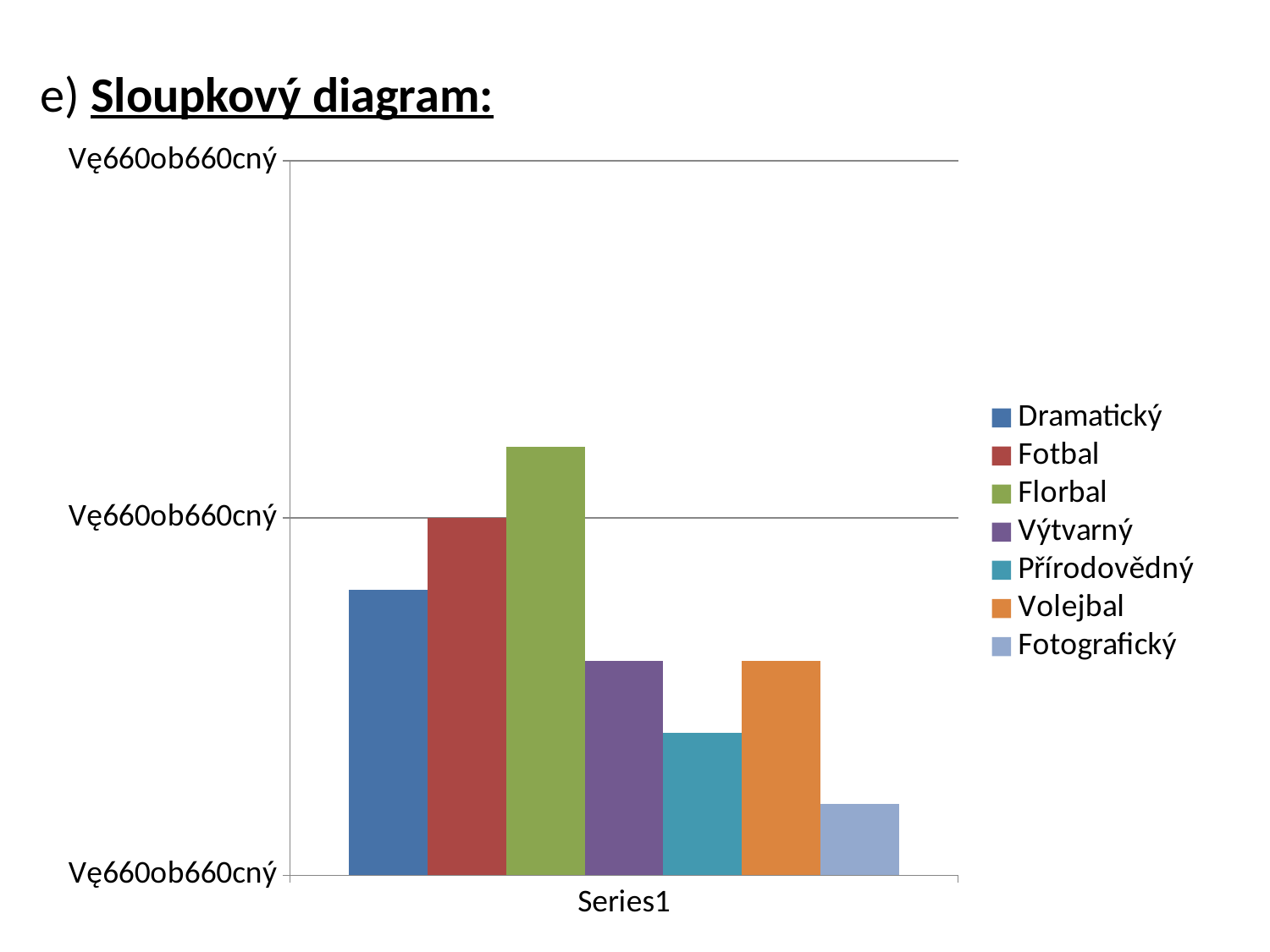
Which legend entry has the shortest bar? Fotografický How many entries does the legend list? 7 Which bar is taller, Dramatický or Volejbal? Dramatický Which bar is taller, Výtvarný or Přírodovědný? Výtvarný What is the label shown on the x axis under the bars? Series1 Which bar is taller, Florbal or Volejbal? Florbal Which legend entry has the tallest bar? Florbal What colour is the bar for Florbal? green What kind of chart is shown on the slide? bar chart